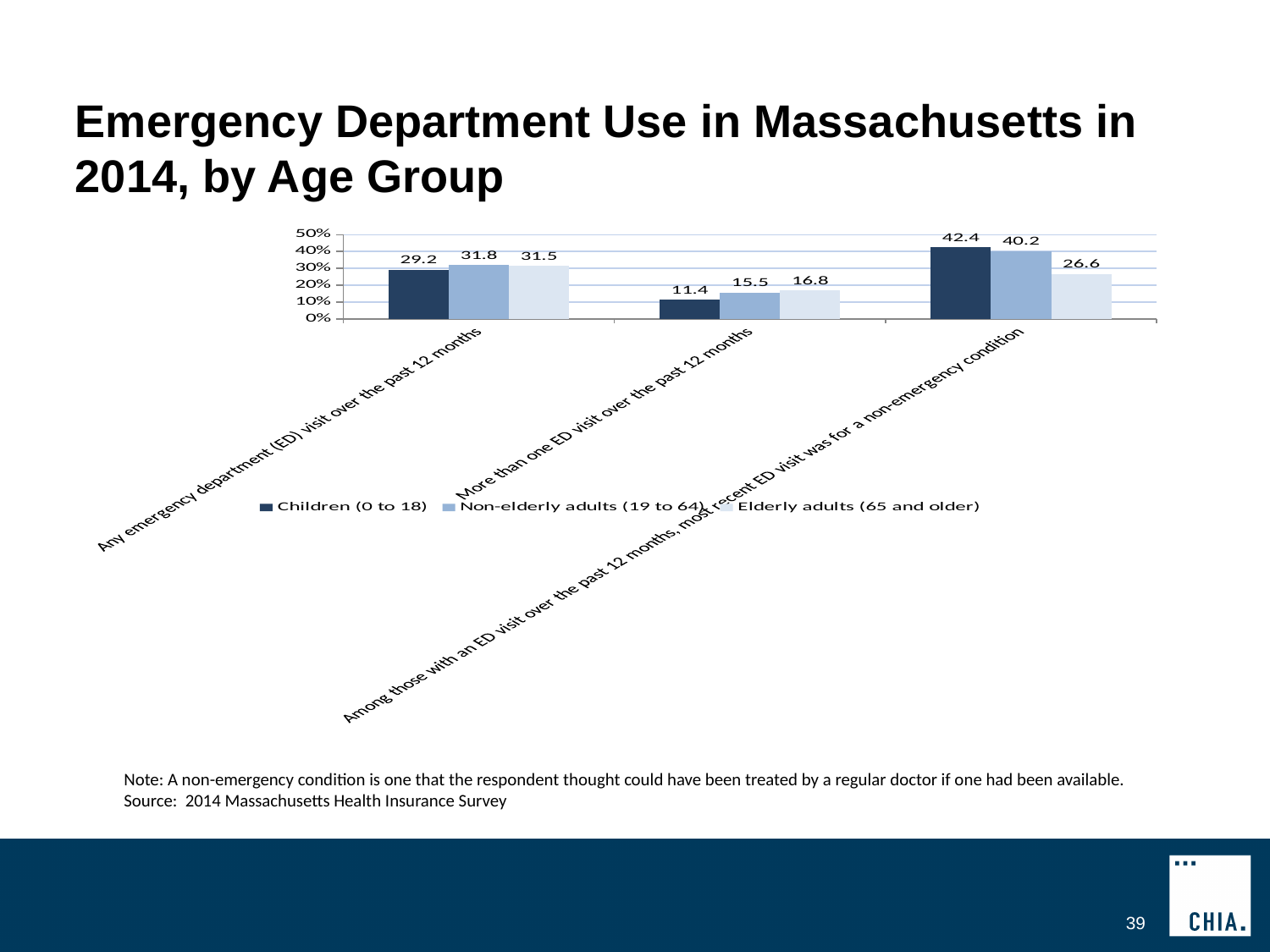
What is the value for Elderly adults (65 and older) for more than one ED visit over the past 12 months? 16.8 What is the difference between Children (0 to 18) and Elderly adults (65 and older) for the most recent ED visit being for a non-emergency condition? 15.8 Is the value for Children (0 to 18) for the most recent ED visit being for a non-emergency condition greater or less than 40%? greater How many series does the legend list? 3 What is the value for Non-elderly adults (19 to 64) for the most recent ED visit being for a non-emergency condition? 40.2 Which is larger for any ED visit over the past 12 months: Children (0 to 18) or Non-elderly adults (19 to 64)? Non-elderly adults (19 to 64) Which age group has the lowest value for more than one ED visit over the past 12 months? Children (0 to 18) What is the value for Children (0 to 18) for any emergency department (ED) visit over the past 12 months? 29.2 Which age group has the highest value for the most recent ED visit being for a non-emergency condition? Children (0 to 18) How many categories are shown on the x axis of the chart? 3 What kind of chart is shown on the slide? Bar chart What is the difference between Non-elderly adults (19 to 64) and Children (0 to 18) for more than one ED visit over the past 12 months? 4.1